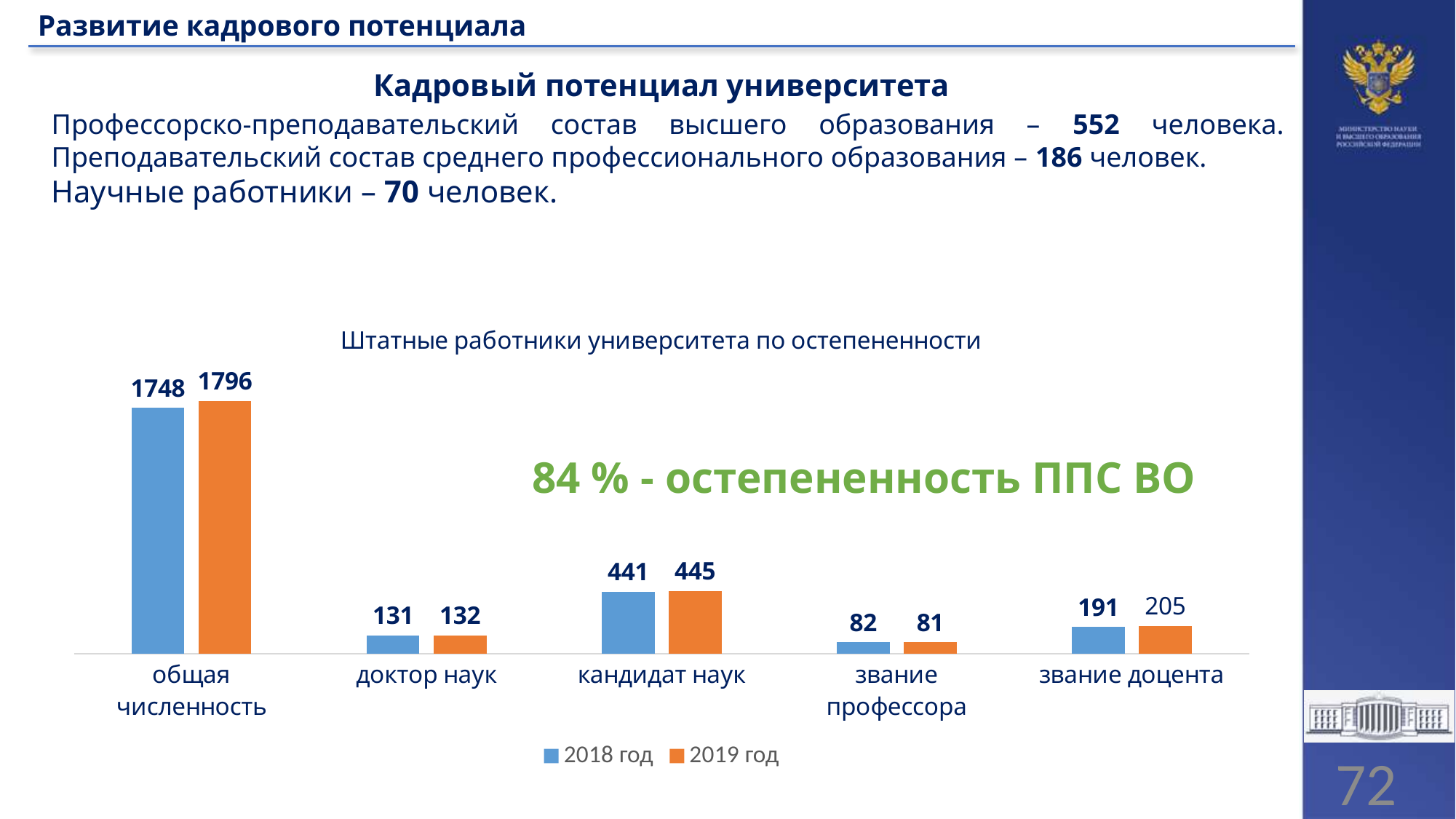
Which category has the highest value in the 2019 год series? общая численность What is the value for 'звание доцента' in the 2019 год series? 205 How many categories are shown on the x axis of the chart? 5 Which category has the lowest value in the 2018 год series? звание профессора What is the value for 'общая численность' in the 2019 год series? 1796 What is the difference between the 2019 год and 2018 год values for 'звание доцента'? 14 What is the difference between the 2019 год and 2018 год values for 'общая численность'? 48 What type of chart is shown on the slide? bar chart What is the value for 'доктор наук' in the 2018 год series? 131 What is the value for 'звание профессора' in the 2018 год series? 82 Which is larger for 'кандидат наук': the 2018 год value or the 2019 год value? 2019 год How many series does the chart legend list? 2